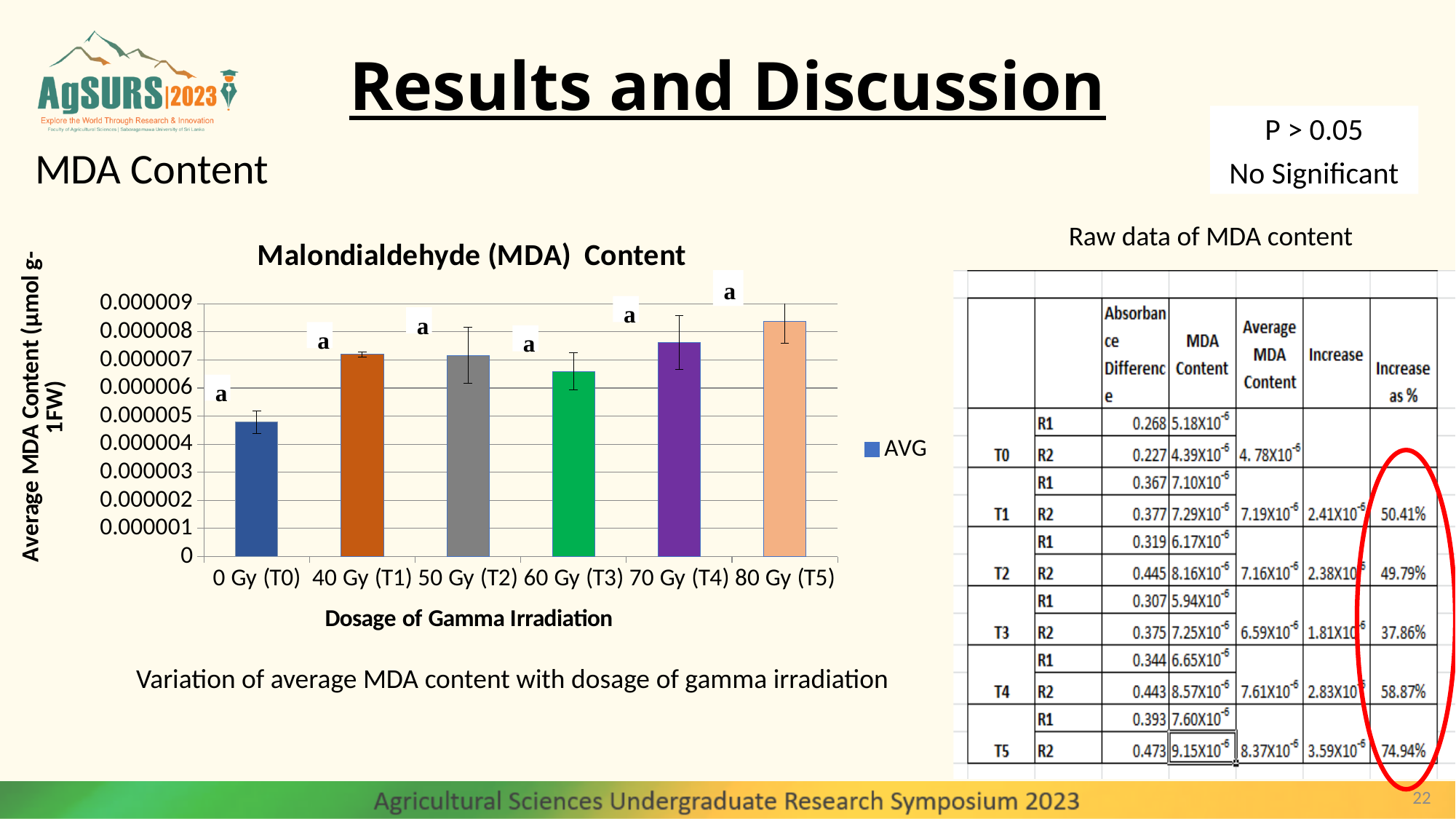
Is the value for 60 Gy (T3) greater or less than 0.000007? less What is the title of the chart? Malondialdehyde (MDA) Content Which dosage has the highest average MDA content in the chart? 80 Gy (T5) Which has the larger average MDA content, 60 Gy (T3) or 70 Gy (T4)? 70 Gy (T4) How many series does the chart legend list? 1 Which dosage has the lowest average MDA content in the chart? 0 Gy (T0) Is the value for 80 Gy (T5) greater or less than 0.000008? greater How many dosage categories are plotted on the x axis of the chart? 6 What is the name of the series shown in the chart legend? AVG Is the value for 0 Gy (T0) greater or less than 0.000004? greater Which has the larger average MDA content, 0 Gy (T0) or 40 Gy (T1)? 40 Gy (T1) What kind of chart is shown on the slide? bar chart